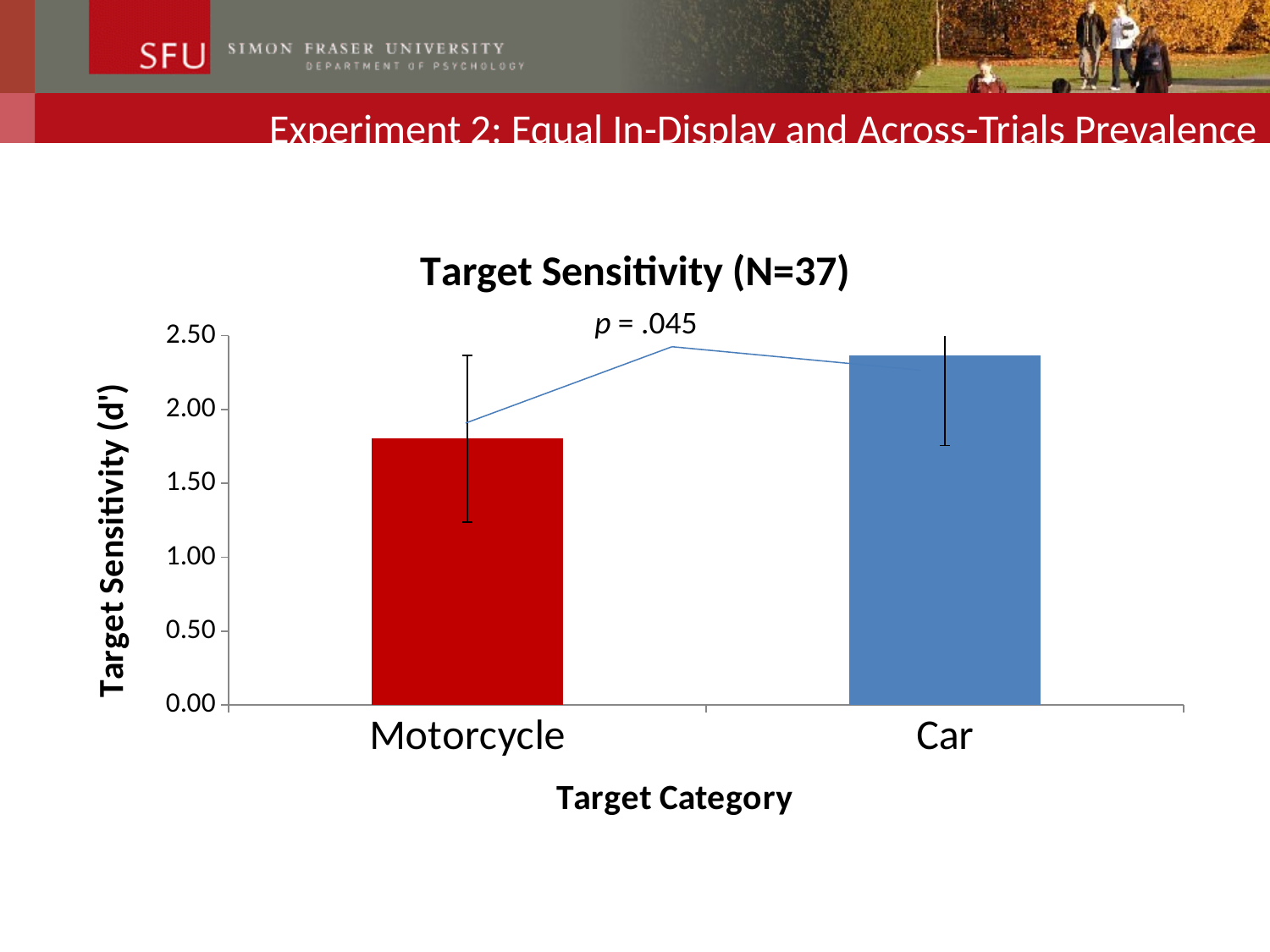
Which target category has the highest target sensitivity? Car What kind of chart is shown on the slide? Bar chart What p value is annotated on the chart? p = .045 Is the target sensitivity for Car greater or less than 2.50? less Is the target sensitivity for Car greater or less than 2.00? greater How many target categories are plotted in the chart? 2 What is the title of the chart? Target Sensitivity (N=37) Is the target sensitivity for Motorcycle greater or less than 1.50? greater Which target category has the lowest target sensitivity? Motorcycle Do the bar values rise or fall from Motorcycle to Car along the x axis? rise Which has the larger target sensitivity, Motorcycle or Car? Car